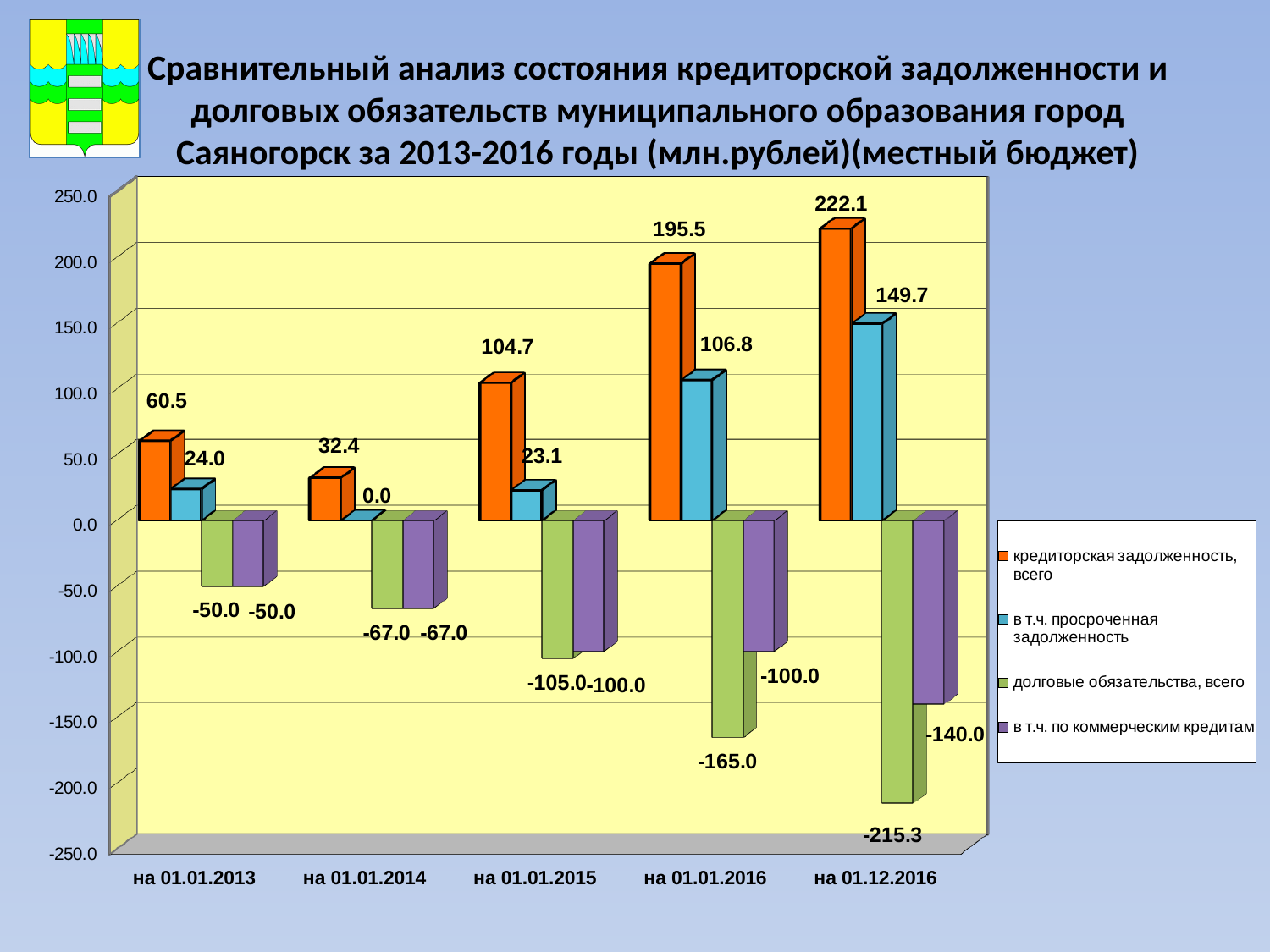
What kind of chart is shown on the slide? Bar chart Does кредиторская задолженность, всего rise or fall from 01.01.2014 to 01.12.2016? Rise What is the value of в т.ч. по коммерческим кредитам on 01.12.2016? -140.0 On which date is кредиторская задолженность, всего the lowest? на 01.01.2014 How many series does the legend list? 4 What is the value of в т.ч. просроченная задолженность on 01.01.2014? 0.0 How many dates are shown on the x axis of the chart? 5 Which is larger: в т.ч. просроченная задолженность on 01.01.2013 or on 01.01.2015? на 01.01.2013 What is the value of кредиторская задолженность, всего on 01.12.2016? 222.1 What is the difference between кредиторская задолженность, всего on 01.12.2016 and on 01.01.2016? 26.6 On which date is кредиторская задолженность, всего the highest? на 01.12.2016 What is the value of долговые обязательства, всего on 01.01.2016? -165.0